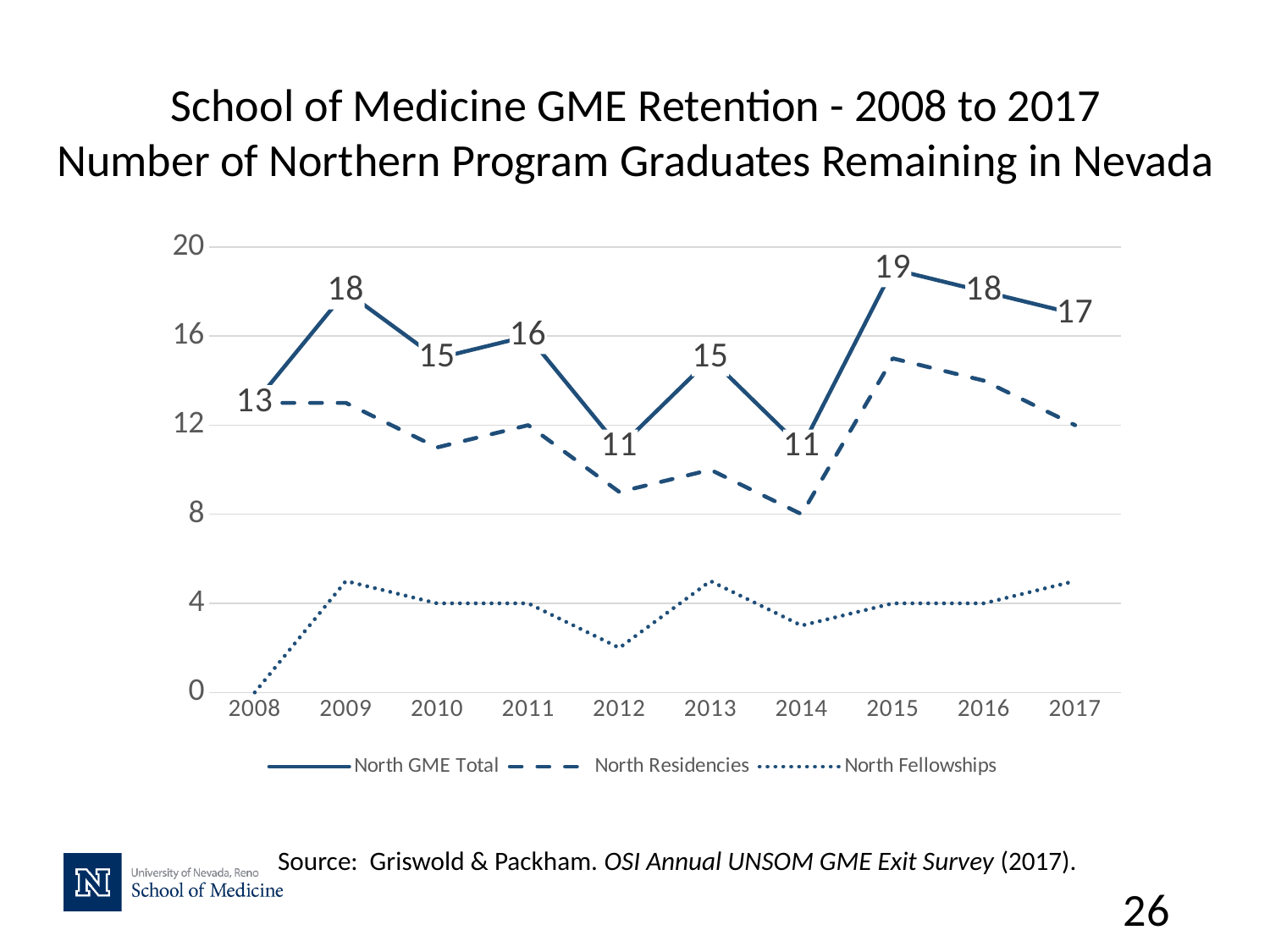
What is the difference between the North GME Total in 2015 and in 2014? 8 In which year is the North GME Total highest? 2015 Which is larger, the North GME Total in 2009 or in 2010? 2009 What type of chart is shown on the slide? line chart How many series does the legend list? 3 Is the North Fellowships value for 2012 greater or less than 4? less How many years are shown on the x axis? 10 Does the North GME Total rise or fall from 2015 to 2017? fall Which series is drawn with a dotted line? North Fellowships What is the North GME Total value for 2015? 19 Is the North Residencies value for 2015 greater or less than 12? greater What is the North GME Total value for 2008? 13